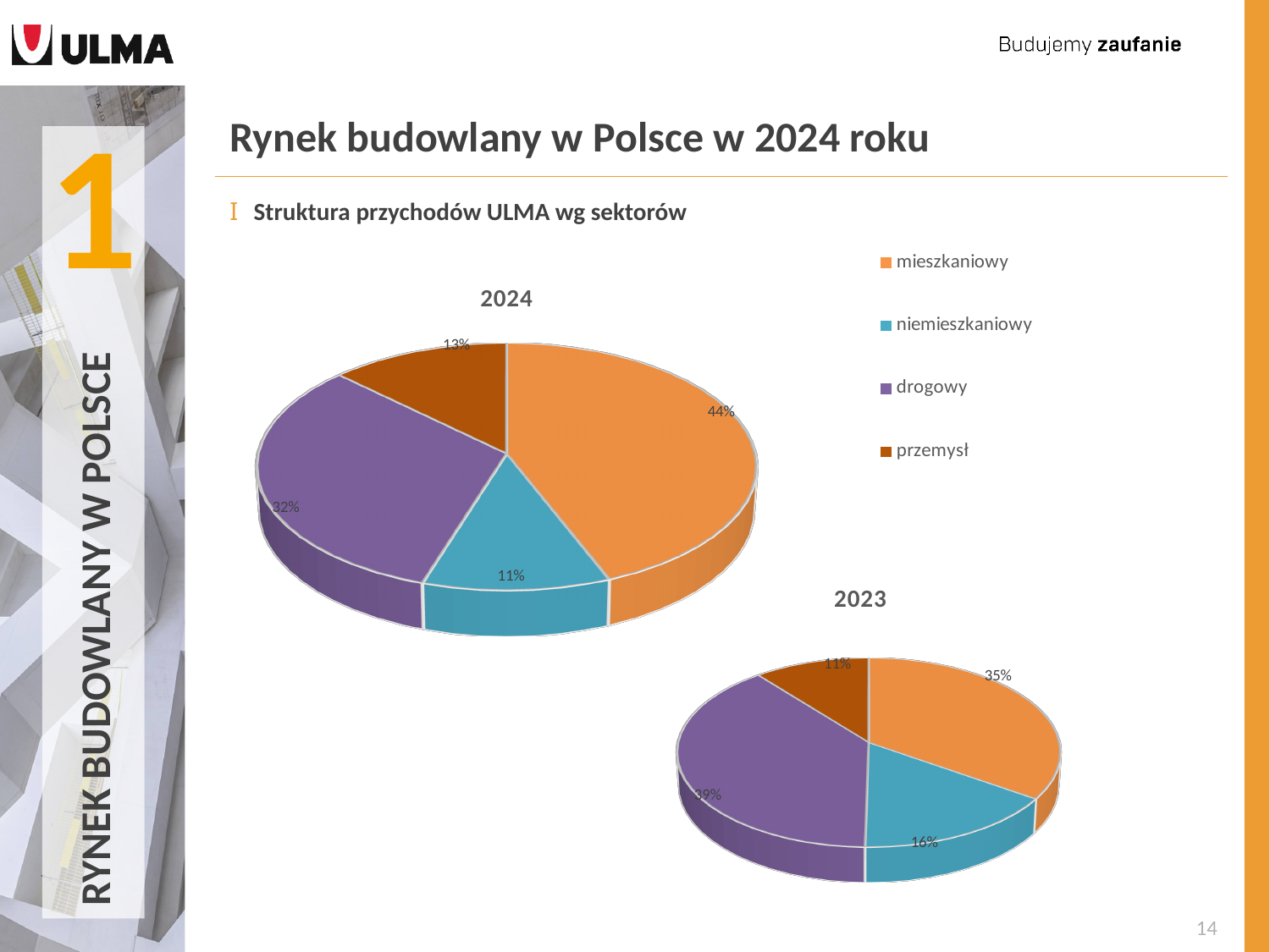
In the 2024 pie chart, which sector has the smallest share? niemieszkaniowy In the 2023 pie chart, what share does przemysł have? 11% In the 2023 pie chart, which is larger: mieszkaniowy or drogowy? drogowy In the 2024 pie chart, what share does drogowy have? 32% In the 2024 pie chart, what share does mieszkaniowy have? 44% In the 2024 pie chart, which sector has the largest share? mieszkaniowy What is the difference between the mieszkaniowy share in the 2024 chart and in the 2023 chart? 9 percentage points What type of chart is used for the 2024 data? pie chart How many sectors does the legend list? 4 In the 2023 pie chart, which sector has the largest share? drogowy In the 2023 pie chart, which sector has the smallest share? przemysł In the 2023 pie chart, what share does niemieszkaniowy have? 16%